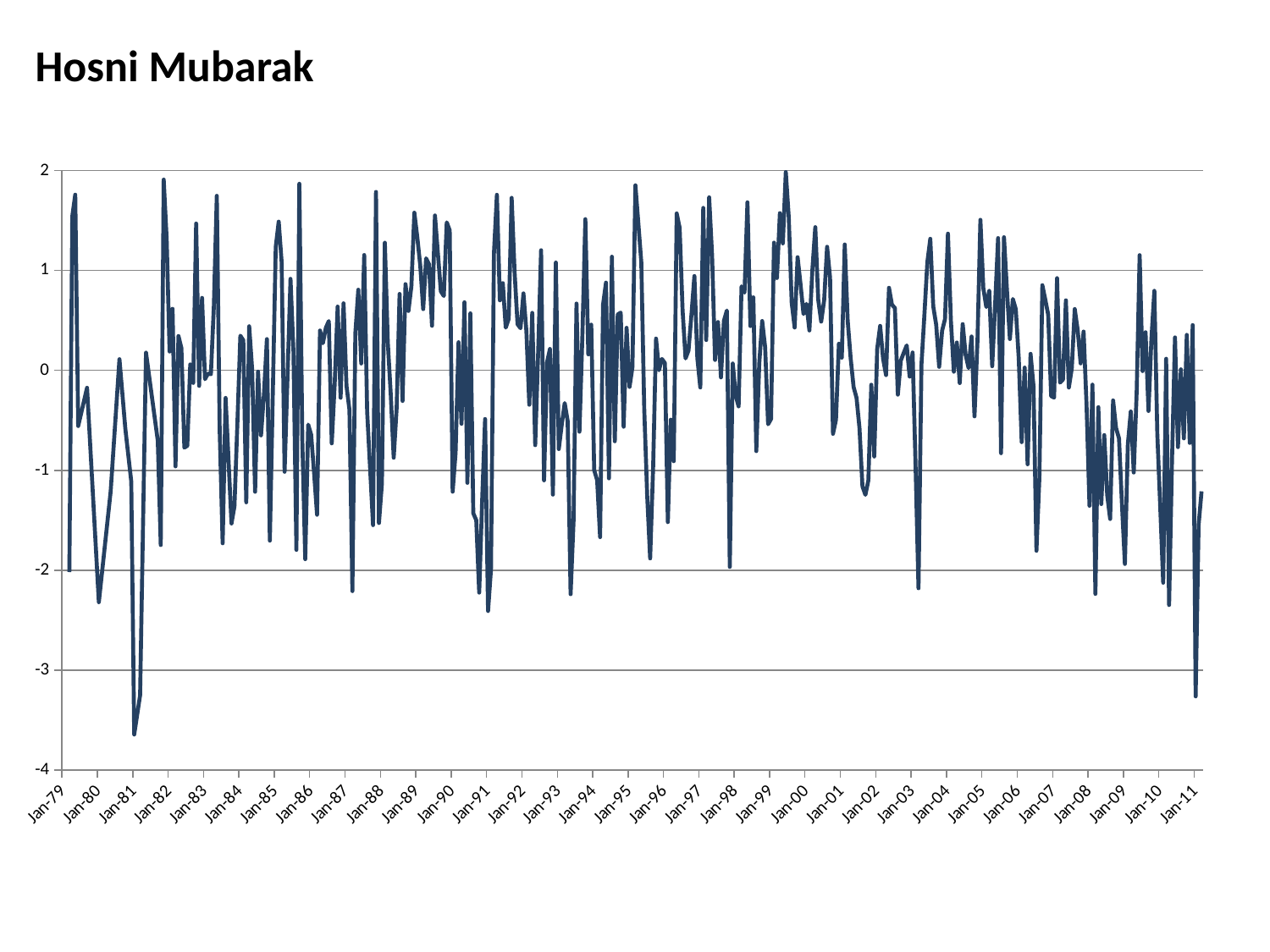
What is the title of the chart? Hosni Mubarak How many date labels are shown along the horizontal axis? 33 What is the lowest value shown on the vertical axis? -4 What kind of chart is shown on the slide? line chart Is the dip in the line near Jan-03 greater or less than -1? less What is the last date label on the horizontal axis? Jan-11 What is the highest value shown on the vertical axis? 2 Is the lowest point of the line, which occurs around Jan-81, greater or less than -3? less Is the sharp dip in the line just before Jan-11 greater or less than -3? less What is the first date label on the horizontal axis? Jan-79